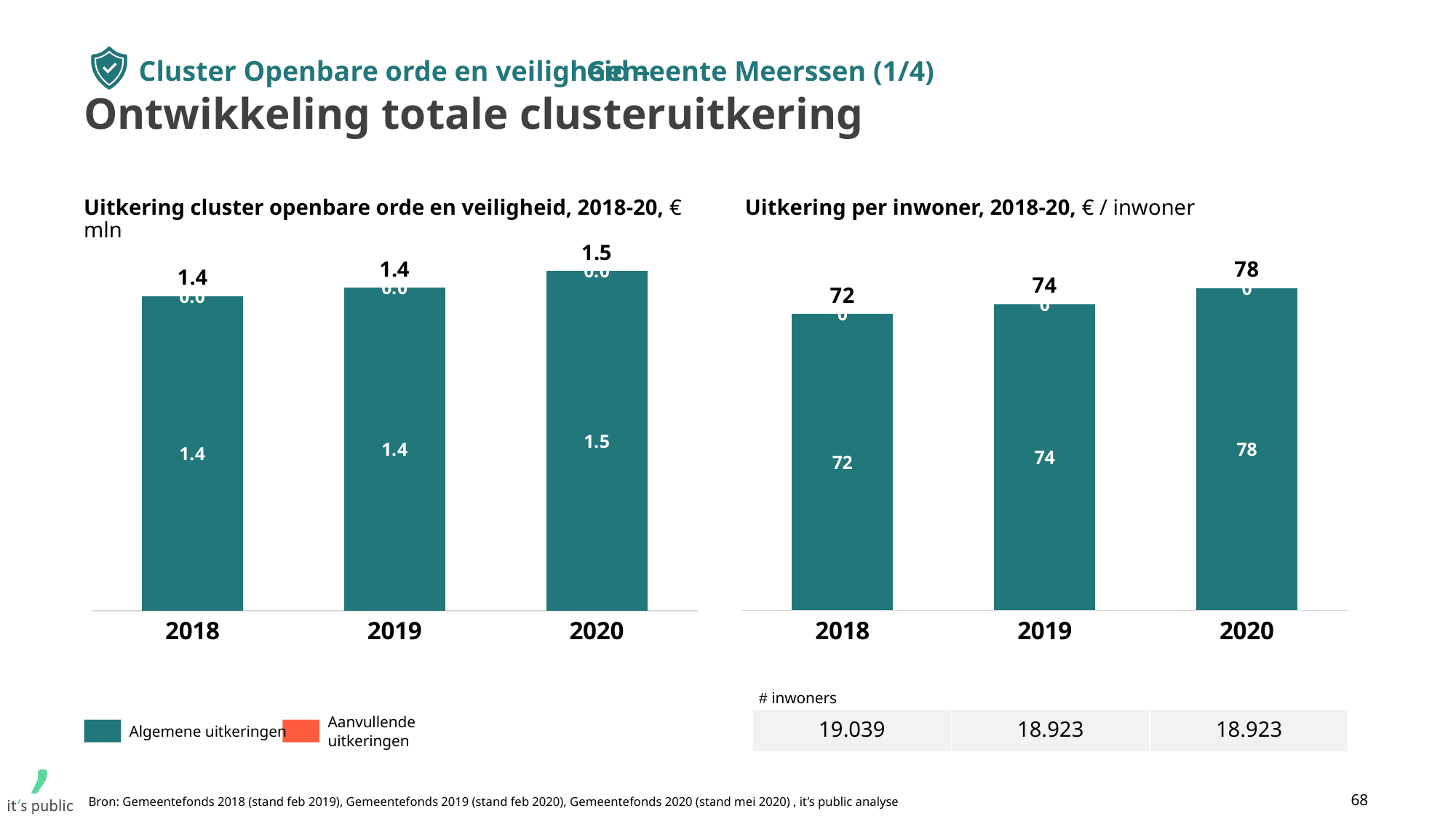
In the right chart (Uitkering per inwoner), which is larger, the value for 2019 or the value for 2020? 2020 In the left chart (Uitkering cluster openbare orde en veiligheid), how many years are shown on the x axis? 3 What is the title of the left chart? Uitkering cluster openbare orde en veiligheid, 2018-20, € mln In the right chart (Uitkering per inwoner), what is the difference between the values for 2020 and 2018? 6 In the right chart (Uitkering per inwoner), do the values rise or fall from 2018 to 2020? Rise What kind of chart is the right chart (Uitkering per inwoner)? Bar chart In the left chart (Uitkering cluster openbare orde en veiligheid), what is the total value for 2020? 1.5 In the right chart (Uitkering per inwoner), what is the value for 2019? 74 In the right chart (Uitkering per inwoner), which year has the highest value? 2020 How many series does the legend of the left chart list? 2 In the right chart (Uitkering per inwoner), which year has the lowest value? 2018 In the left chart (Uitkering cluster openbare orde en veiligheid), what is the value of Algemene uitkeringen for 2018? 1.4